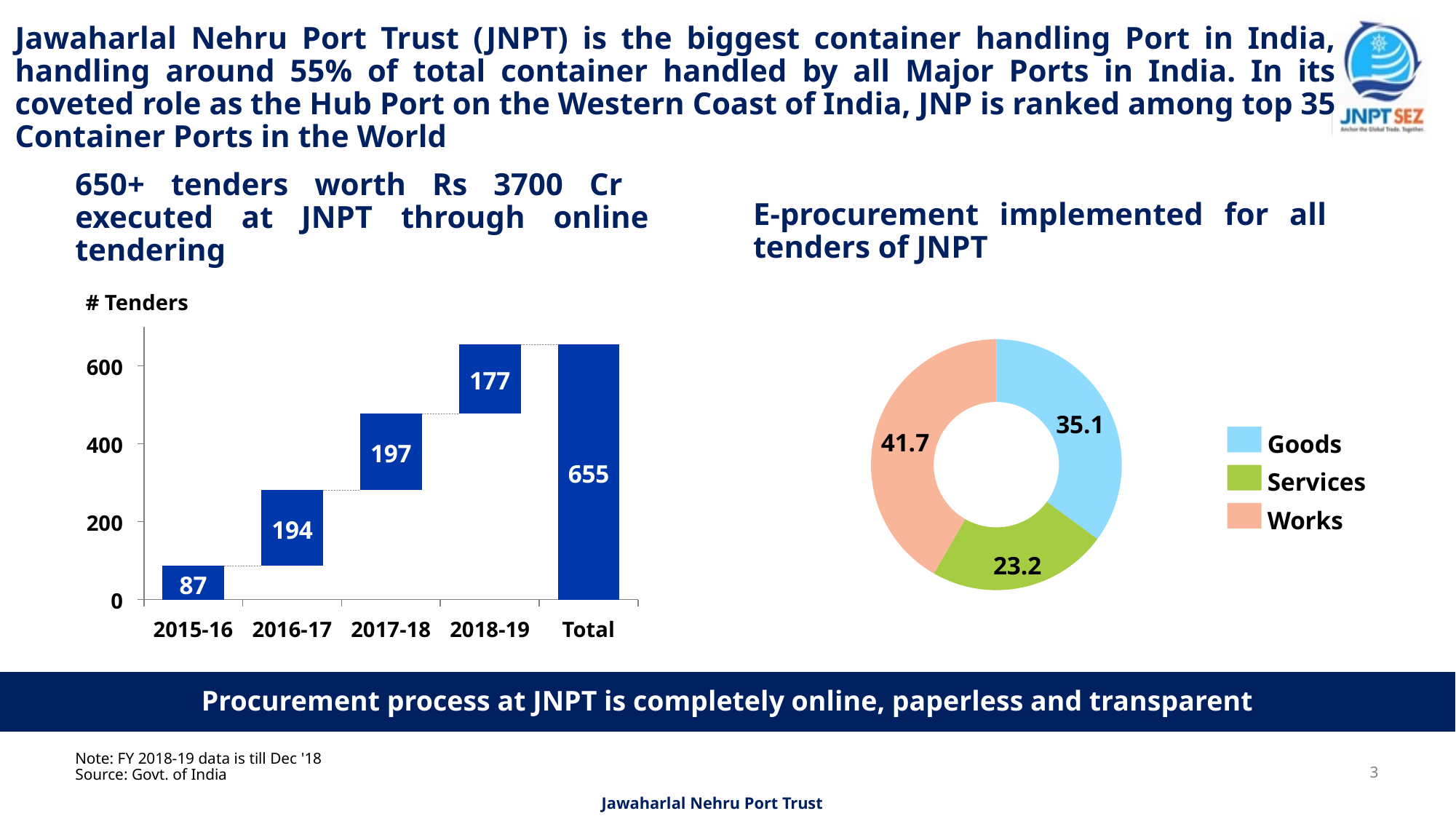
How many entries does the legend of the donut chart on the right list? 3 In the '# Tenders' chart, how many tenders are shown for 2015-16? 87 How many categories are shown on the x axis of the '# Tenders' chart? 5 In the donut chart on the right, what is the value for Works? 41.7 In the '# Tenders' chart, what is the value of the Total bar? 655 In the '# Tenders' chart, which year has the lowest number of tenders? 2015-16 In the '# Tenders' chart, is the Total bar greater or less than 600? greater In the donut chart on the right, which category has the smallest share? Services In the '# Tenders' chart, what is the difference between the 2016-17 and 2015-16 values? 107 What kind of chart is the '# Tenders' chart on the left? Bar chart In the '# Tenders' chart, which is larger, the value for 2016-17 or the value for 2018-19? 2016-17 In the '# Tenders' chart, what is the value labelled on the 2017-18 bar? 197